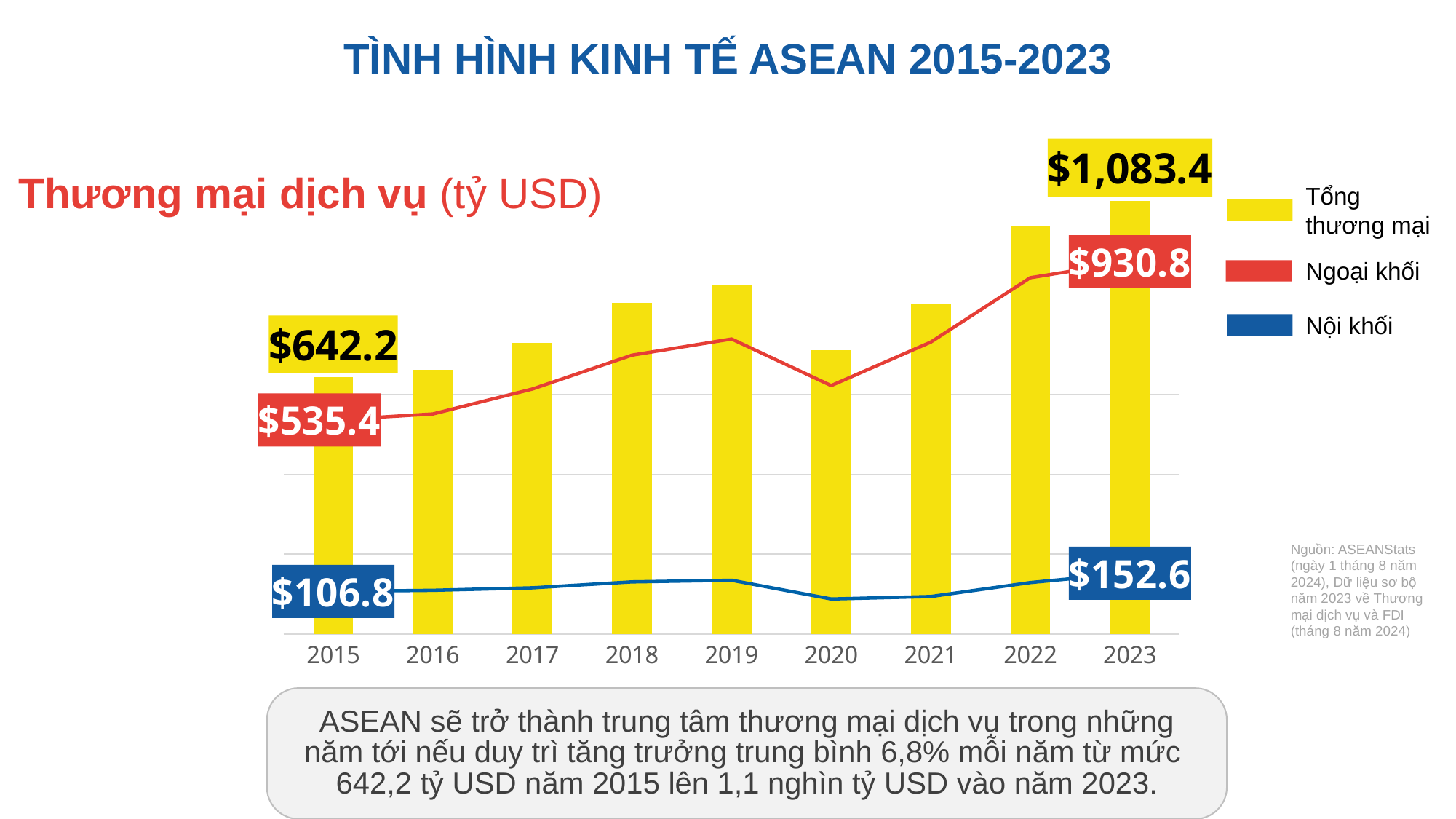
What is the value of Nội khối for 2015? $106.8 How many series does the legend list? 3 By how much did Tổng thương mại increase from 2015 to 2023? $441.2 What is the difference between Ngoại khối in 2023 and in 2015? $395.4 What is the value of Ngoại khối for 2023? $930.8 Is the Tổng thương mại bar higher in 2019 or in 2020? 2019 What is the overall trend of the Ngoại khối line from 2015 to 2023? Rising Which year has the highest Tổng thương mại bar? 2023 What is the value of Tổng thương mại for 2015? $642.2 What is the value of Tổng thương mại for 2023? $1,083.4 Which year has the lowest Tổng thương mại bar? 2015 How many years are shown on the x axis of the chart? 9